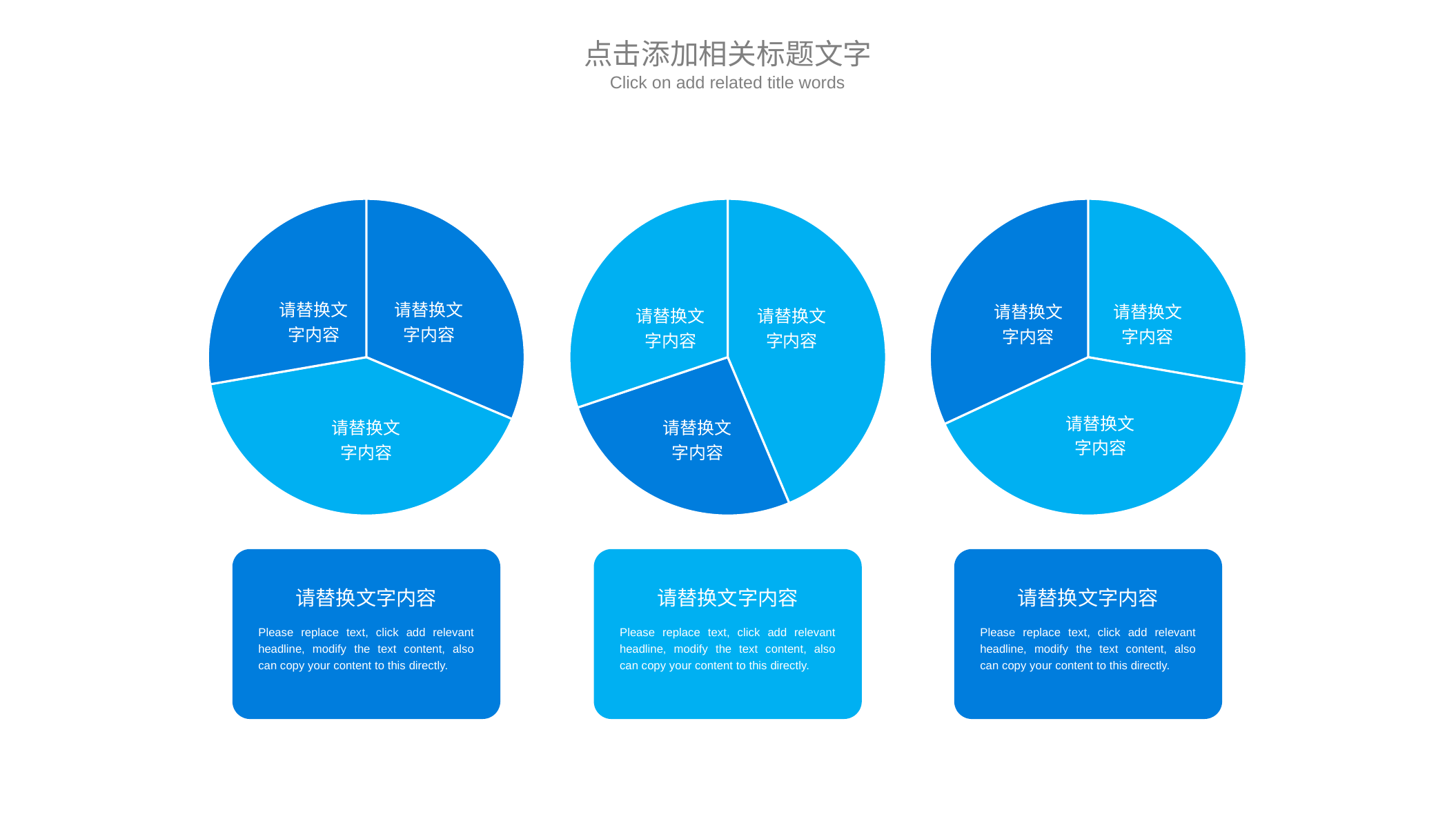
What kind of chart is the left chart on the slide? pie chart How many slices does the right pie chart have? 3 How many slices does the middle pie chart have? 3 In the middle pie chart, which slice is the largest: the top-left, the bottom, or the right slice? the right slice In the middle pie chart, is the right slice larger or smaller than the bottom slice? larger How many slices does the left pie chart have? 3 In the left pie chart, what colour is the bottom (largest) slice? light blue What kind of chart is the middle chart on the slide? pie chart How many pie charts are shown on the slide? 3 In the right pie chart, which slice is the largest: the top-left, the top-right, or the bottom slice? the bottom slice In the left pie chart, which slice is the largest: the top-left, the top-right, or the bottom slice? the bottom slice